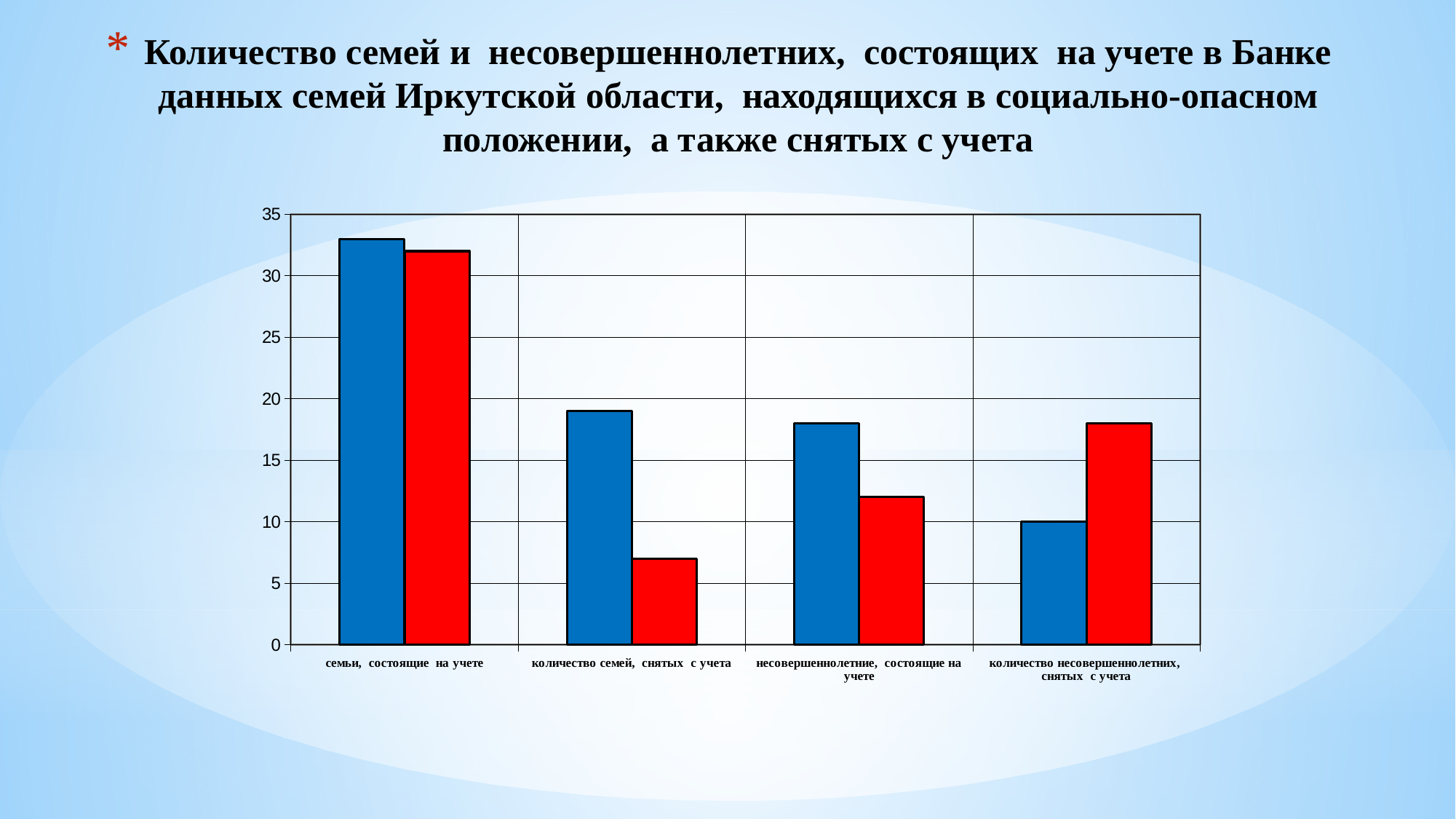
Is the red bar for 'количество семей, снятых с учета' greater or less than 10? less For 'количество семей, снятых с учета', which bar is taller, the blue one or the red one? the blue one For 'количество несовершеннолетних, снятых с учета', which bar is taller, the blue one or the red one? the red one What kind of chart is shown on the slide? bar chart What two colours are used for the bars on the chart? blue and red Is the blue bar for 'семьи, состоящие на учете' greater or less than 30? greater Which category has the shortest red bar? количество семей, снятых с учета Which category has the tallest blue bar? семьи, состоящие на учете How many bars are shown for each category on the chart? 2 What is the value of the blue bar for 'количество несовершеннолетних, снятых с учета'? 10 Is the red bar for 'несовершеннолетние, состоящие на учете' greater or less than 10? greater How many categories are shown on the x axis of the chart? 4